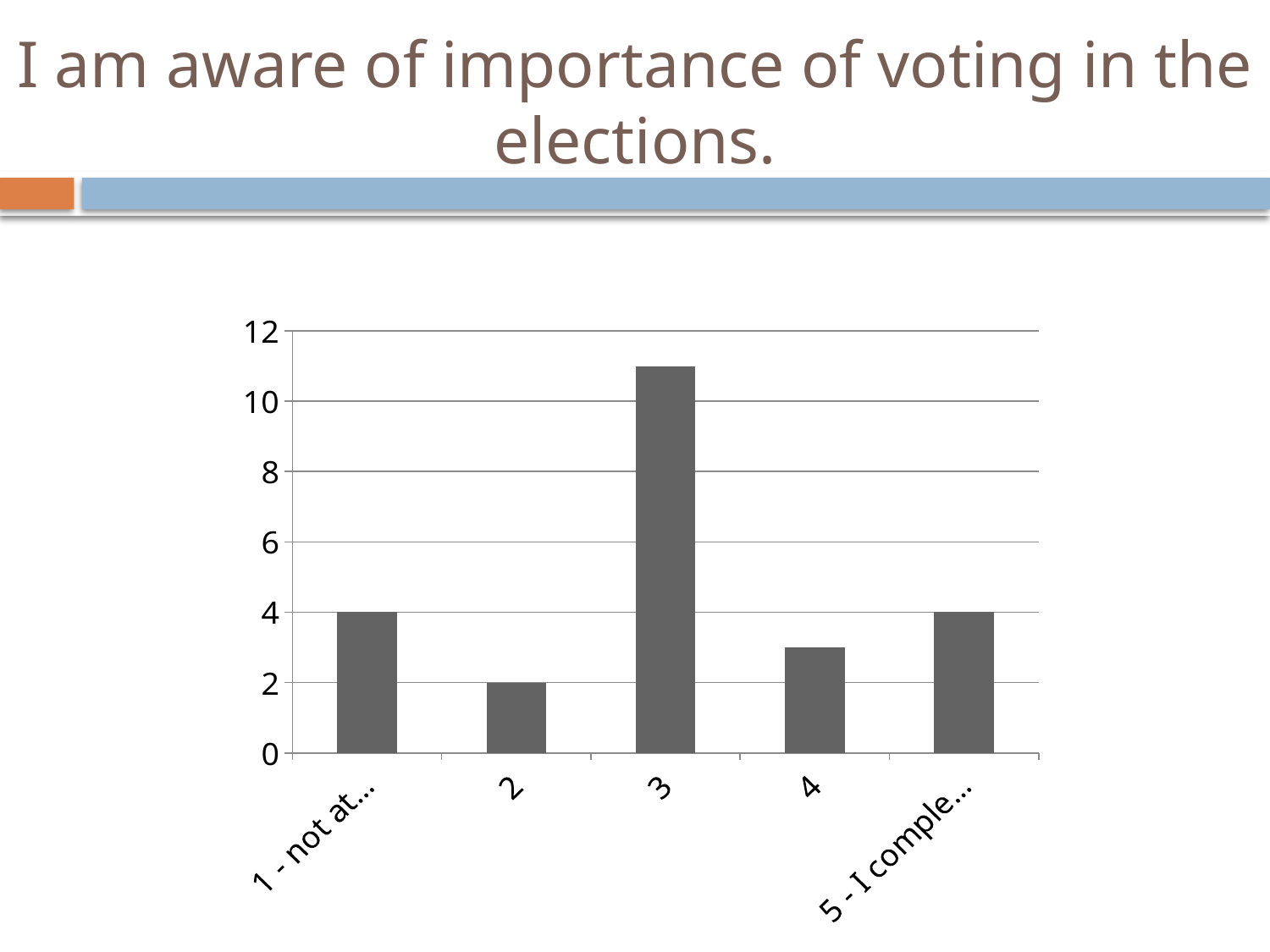
What is the value for category 2? 2 What is the value for the category labelled "5 - I comple..."? 4 What is the title of the slide containing the chart? I am aware of importance of voting in the elections. Is the value for category 3 greater or less than 10? greater Which category has the lowest bar in the chart? 2 How many categories are shown on the x axis of the chart? 5 Which is larger, the value for category 3 or the value for category 4? 3 Which category has the highest bar in the chart? 3 Is the value for category 4 greater or less than 4? less What is the difference between the value for "1 - not at..." and the value for category 2? 2 What is the value for the category labelled "1 - not at..."? 4 What type of chart is shown on the slide? bar chart